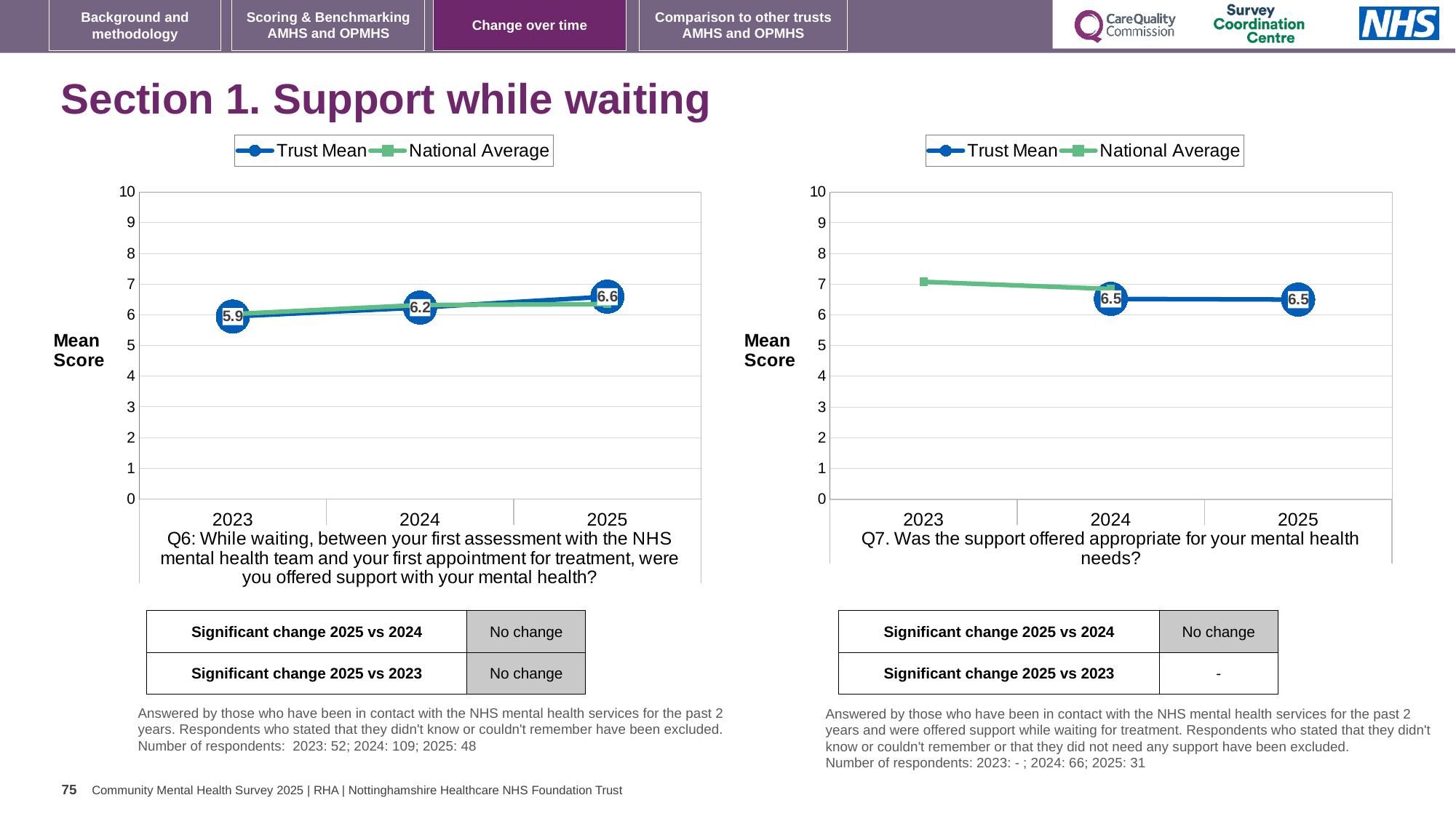
On the Q6 chart (left), what is the Trust Mean score for 2024? 6.2 On the Q6 chart (left), what is the difference between the Trust Mean scores for 2025 and 2023? 0.7 What kind of chart is the Q6 chart (left)? line chart How many series does the legend of the Q7 chart (right) list? 2 On the Q6 chart (left), which year has the highest Trust Mean score? 2025 On the Q7 chart (right), what is the Trust Mean score for 2024? 6.5 On the Q6 chart (left), which year has the lowest Trust Mean score? 2023 On the Q6 chart (left), does the Trust Mean rise or fall from 2023 to 2025? rise On the Q7 chart (right), what is the Trust Mean score for 2025? 6.5 On the Q6 chart (left), what is the Trust Mean score for 2025? 6.6 On the Q6 chart (left), what is the Trust Mean score for 2023? 5.9